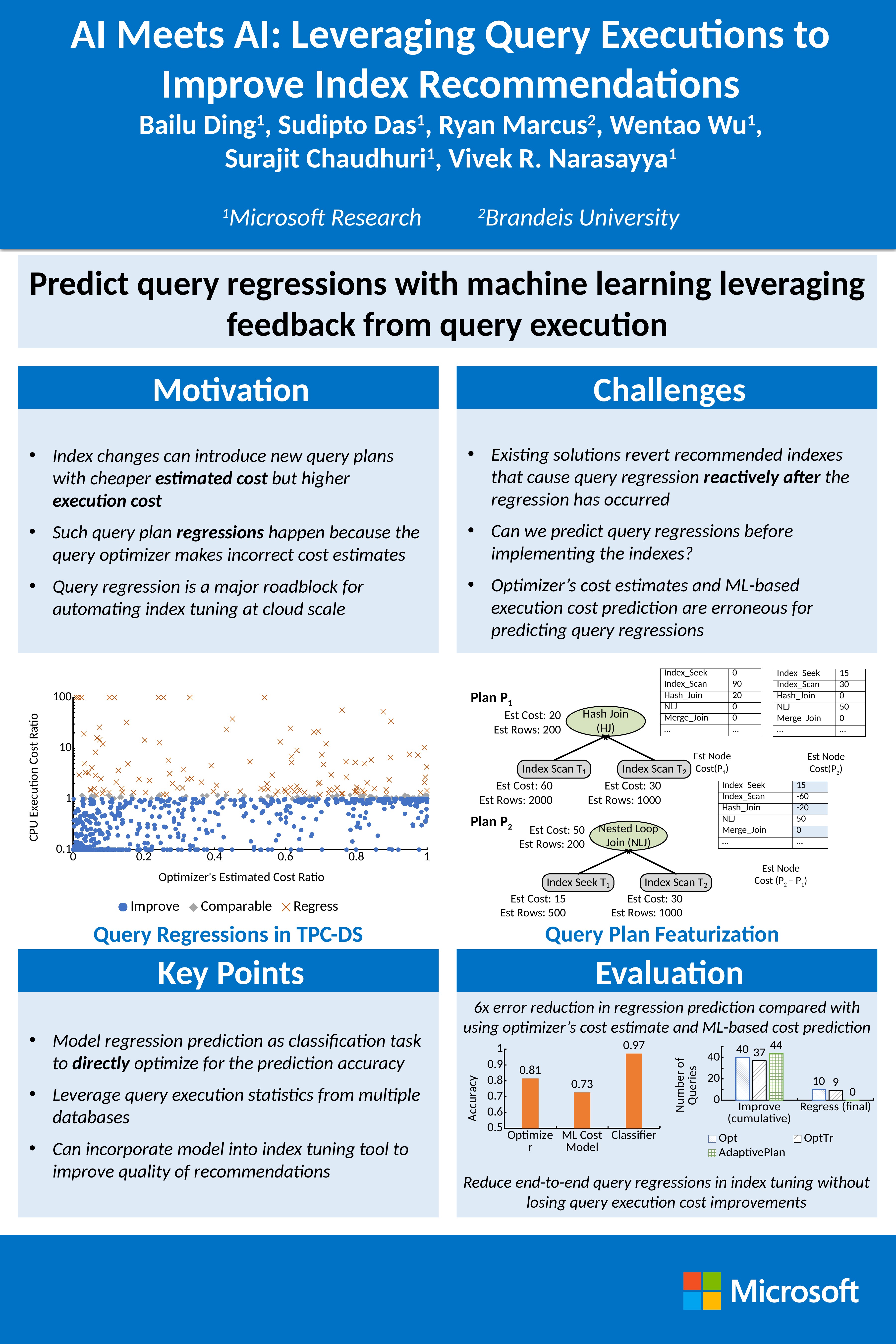
In the accuracy bar chart in the Evaluation section, which method has the lowest accuracy? ML Cost Model In the Number of Queries bar chart in the Evaluation section, how many queries does AdaptivePlan have in the Regress (final) category? 0 In the accuracy bar chart in the Evaluation section, what is the difference in accuracy between the Classifier and the Optimizer? 0.16 In the Number of Queries bar chart in the Evaluation section, which series has the most queries in the Improve (cumulative) category? AdaptivePlan In the accuracy bar chart in the Evaluation section, what is the accuracy of the Classifier? 0.97 In the Number of Queries bar chart in the Evaluation section, what is the difference between Opt and OptTr in the Regress (final) category? 1 In the accuracy bar chart in the Evaluation section, which method has the highest accuracy? Classifier In the accuracy bar chart in the Evaluation section, how many methods are compared? 3 In the accuracy bar chart in the Evaluation section, what is the accuracy of the ML Cost Model? 0.73 How many series does the legend of the Number of Queries bar chart in the Evaluation section list? 3 In the Number of Queries bar chart in the Evaluation section, how many queries does AdaptivePlan have in the Improve (cumulative) category? 44 What type of chart is the Query Regressions in TPC-DS chart? Scatter plot